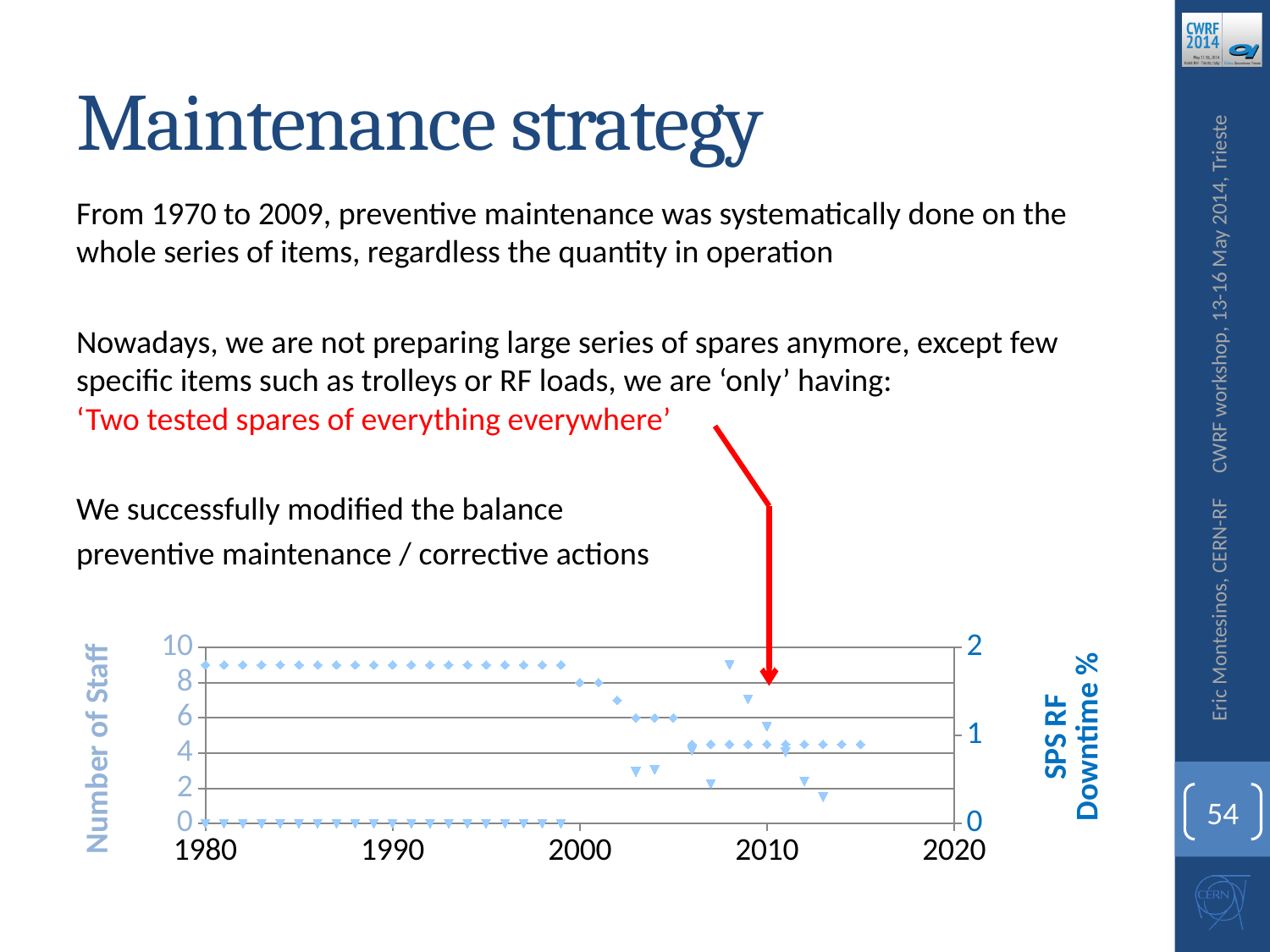
What is the label of the left vertical axis of the chart? Number of Staff Does the Number of Staff rise or fall from 1980 to 2015 along the x axis? fall What is the label of the right vertical axis of the chart? SPS RF Downtime % Is the Number of Staff in 2004 greater or less than 4? greater Is the SPS RF Downtime % in 2013 greater or less than 1? less Is the Number of Staff in 1980 greater or less than 8? greater What kind of chart is shown at the bottom of the slide? scatter chart What is the maximum value shown on the left vertical axis (Number of Staff)? 10 What is the maximum value shown on the right vertical axis (SPS RF Downtime %)? 2